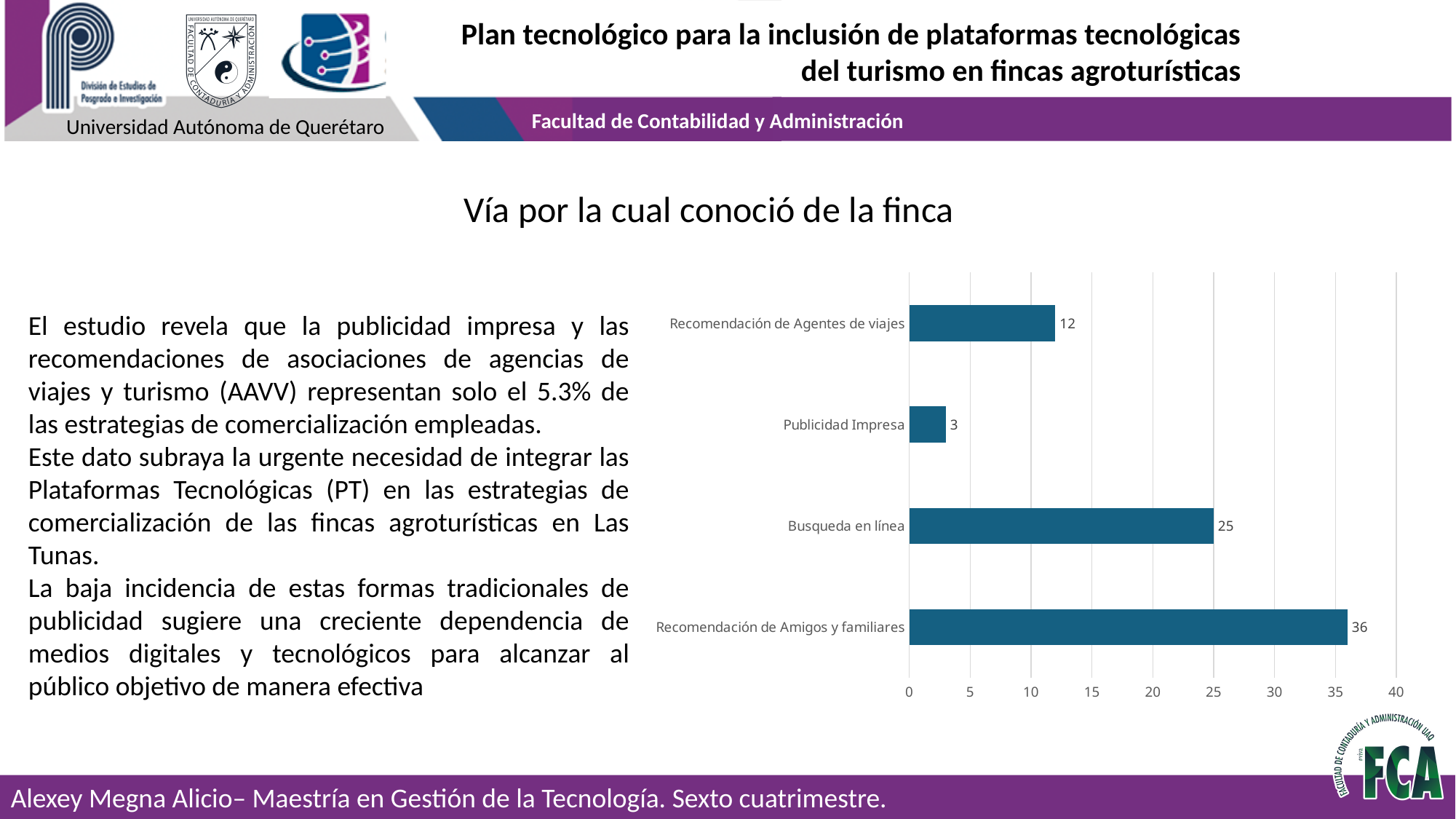
What is the value for Recomendación de Agentes de viajes? 12 Is the value for Busqueda en línea greater or less than 20? greater Which category has the lowest value? Publicidad Impresa Which is larger, the value for Recomendación de Agentes de viajes or the value for Publicidad Impresa? Recomendación de Agentes de viajes What is the value for Busqueda en línea? 25 What is the value for Publicidad Impresa? 3 What is the difference between the values for Recomendación de Amigos y familiares and Busqueda en línea? 11 What is the value for Recomendación de Amigos y familiares? 36 What is the title of the chart? Vía por la cual conoció de la finca What kind of chart is shown on the slide? bar chart How many categories are shown in the chart? 4 Which category has the highest value? Recomendación de Amigos y familiares